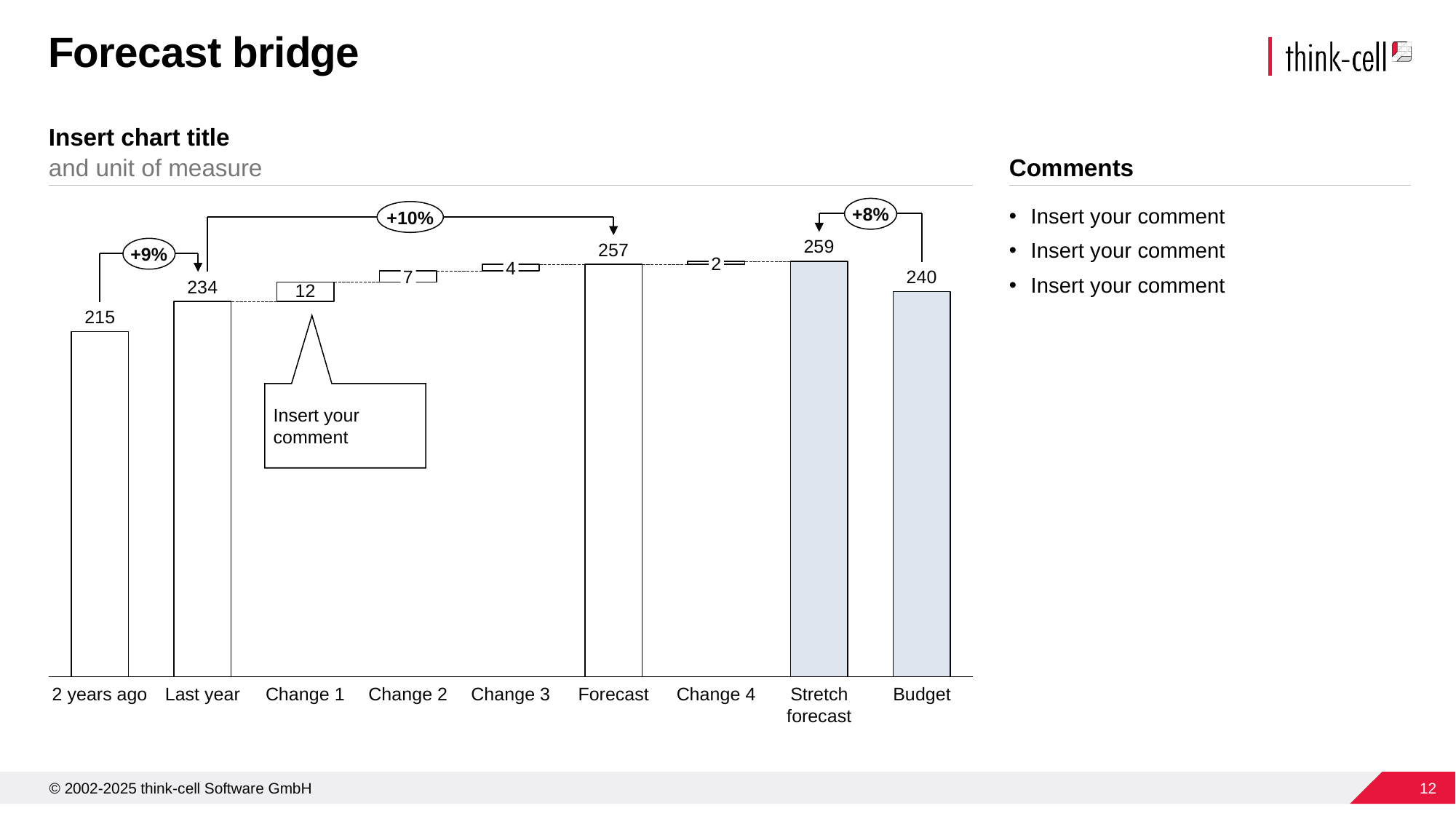
What is the difference between the Stretch forecast value and the Budget value? 19 What is the value for Forecast? 257 What is the value for Budget? 240 What is the difference between the Forecast value and the Last year value? 23 Which category has the highest value? Stretch forecast What is the value for Last year? 234 What percentage change is shown between Last year and Forecast? +10% What is the value for 2 years ago? 215 What percentage change is shown between 2 years ago and Last year? +9% What is the value for Change 1? 12 Which is larger, the value for Change 2 or the value for Change 3? Change 2 How many categories are shown on the x axis? 9